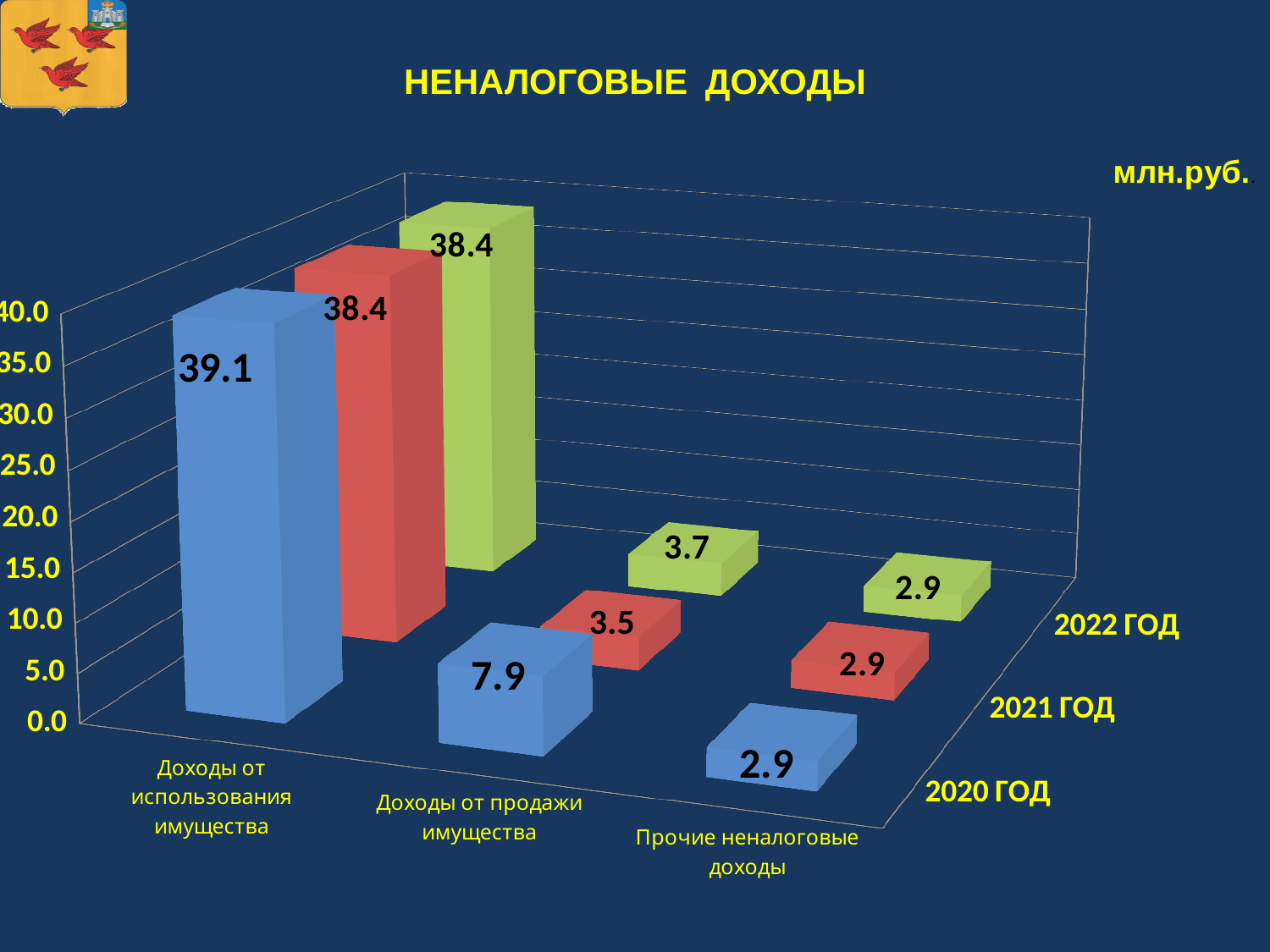
What unit of measurement is indicated on the slide? млн.руб. What is the value for Доходы от продажи имущества in 2020 ГОД? 7.9 How many years (series) are plotted in the chart? 3 Which category has the highest value in 2020 ГОД? Доходы от использования имущества What type of chart is shown on the slide? bar chart How many categories are shown on the x axis? 3 What is the value for Доходы от продажи имущества in 2022 ГОД? 3.7 Which category has the lowest value in 2022 ГОД? Прочие неналоговые доходы What is the value for Доходы от использования имущества in 2020 ГОД? 39.1 What is the difference between the 2020 ГОД and 2021 ГОД values for Доходы от продажи имущества? 4.4 Which is larger for Доходы от использования имущества: the 2020 ГОД value or the 2021 ГОД value? 2020 ГОД What is the value for Прочие неналоговые доходы in 2021 ГОД? 2.9